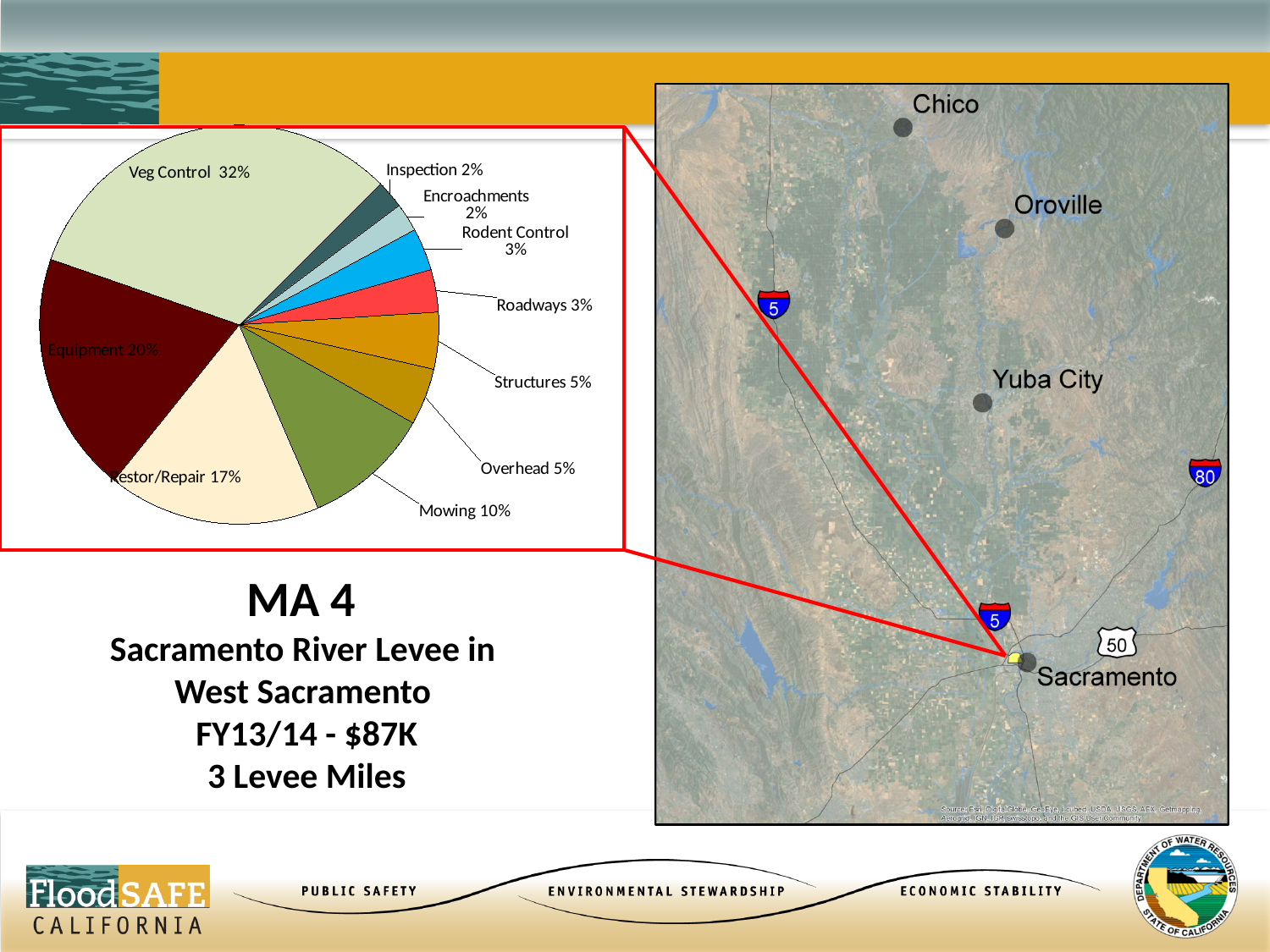
What is the combined share of Structures and Overhead? 10% What percentage is shown for Equipment? 20% What percentage is shown for Restor/Repair? 17% What is the difference in percentage points between Equipment and Restor/Repair? 3 Which category has the largest share of the pie? Veg Control What kind of chart is shown on the slide? pie chart What percentage is shown for Rodent Control? 3% Which is larger, the share for Mowing or the share for Structures? Mowing Which two categories each have a 2% share? Inspection and Encroachments How many slices does the pie chart have? 10 What share of the pie does Veg Control represent? 32% What percentage is shown for Mowing? 10%